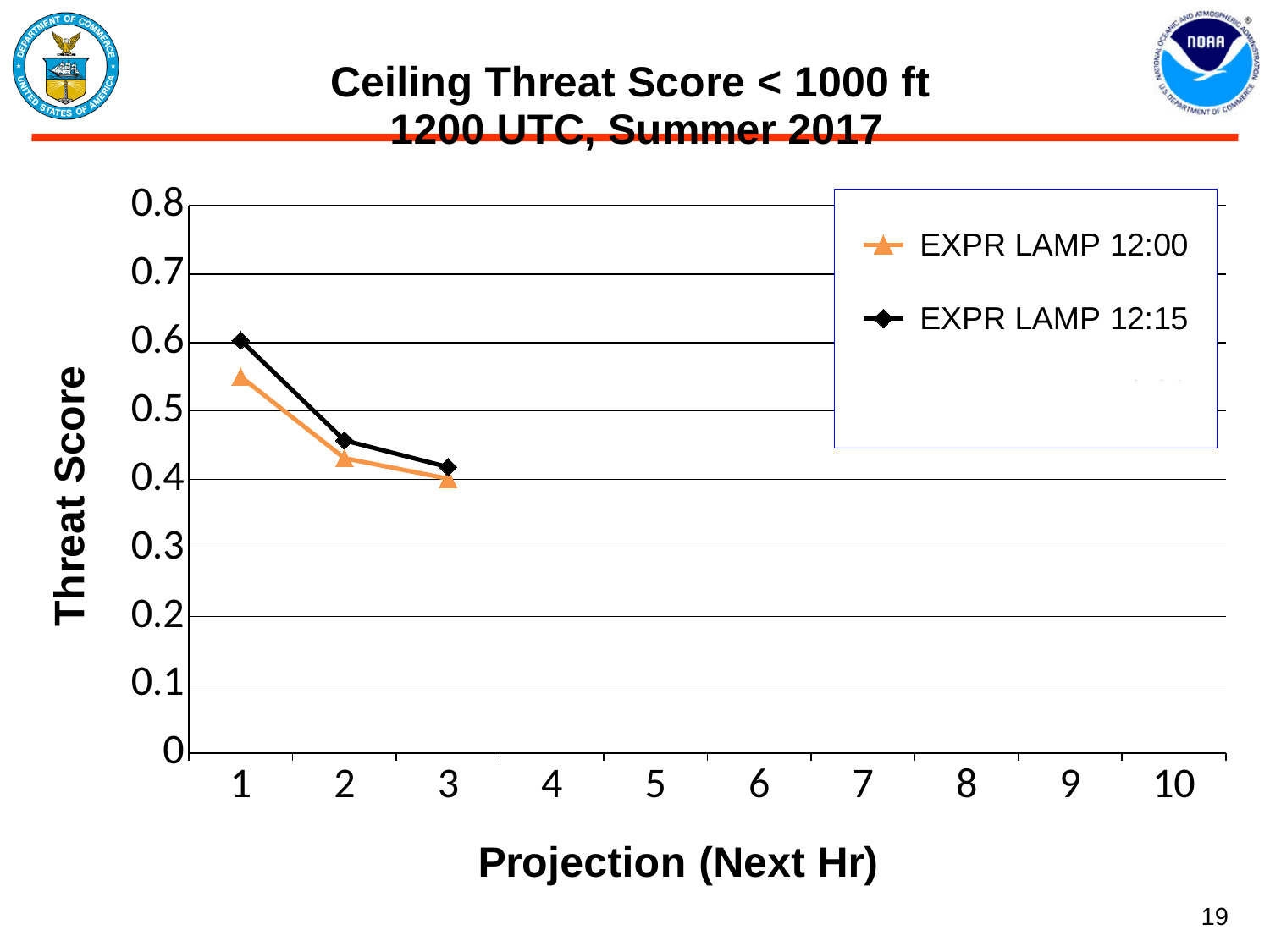
Is the threat score for EXPR LAMP 12:15 at projection 2 greater or less than 0.5? less What is the label of the y axis? Threat Score Does the threat score for EXPR LAMP 12:00 rise or fall as the projection increases from 1 to 3? fall Is the threat score for EXPR LAMP 12:15 at projection 1 greater or less than 0.5? greater At which projection hour does EXPR LAMP 12:15 have its highest threat score? 1 Does the threat score for EXPR LAMP 12:15 rise or fall as the projection increases from 1 to 3? fall Is the threat score for EXPR LAMP 12:00 at projection 1 greater or less than 0.5? greater For how many projection hours are data points plotted for each series? 3 At projection 1, which series has the higher threat score, EXPR LAMP 12:00 or EXPR LAMP 12:15? EXPR LAMP 12:15 How many series does the legend list? 2 What are the two series named in the legend? EXPR LAMP 12:00 and EXPR LAMP 12:15 What kind of chart is shown on the slide? line chart